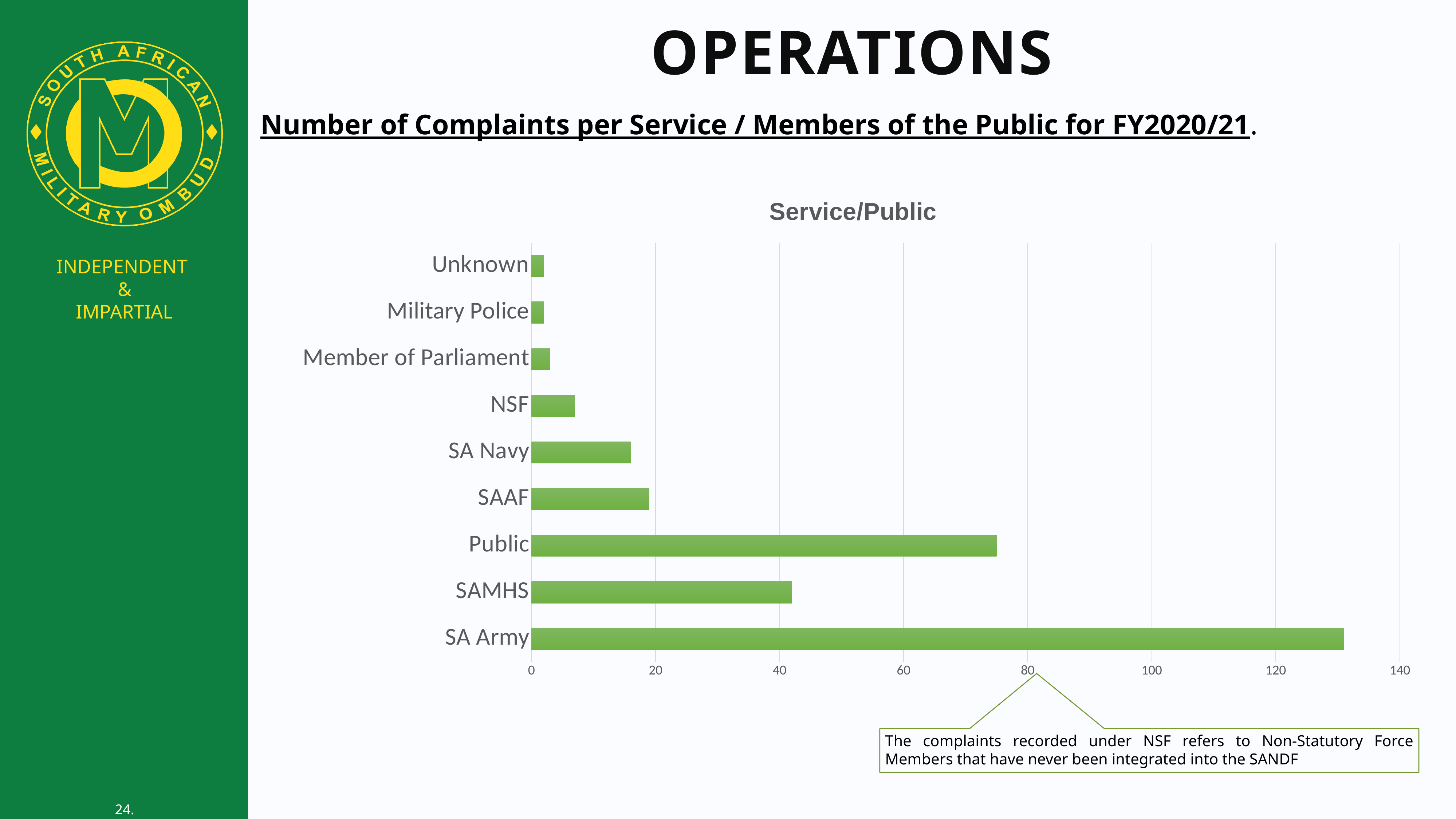
What kind of chart is shown on the slide? bar chart Is the value for NSF greater or less than 20? less What is the title shown above the chart? Service/Public Which category has the highest number of complaints? SA Army Is the value for SA Army greater or less than 120? greater Which has more complaints, Public or SAMHS? Public How many categories are plotted in the Service/Public chart? 9 Is the value for Public greater or less than 80? less Which has more complaints, SA Army or Public? SA Army What colour are the bars in the chart? green